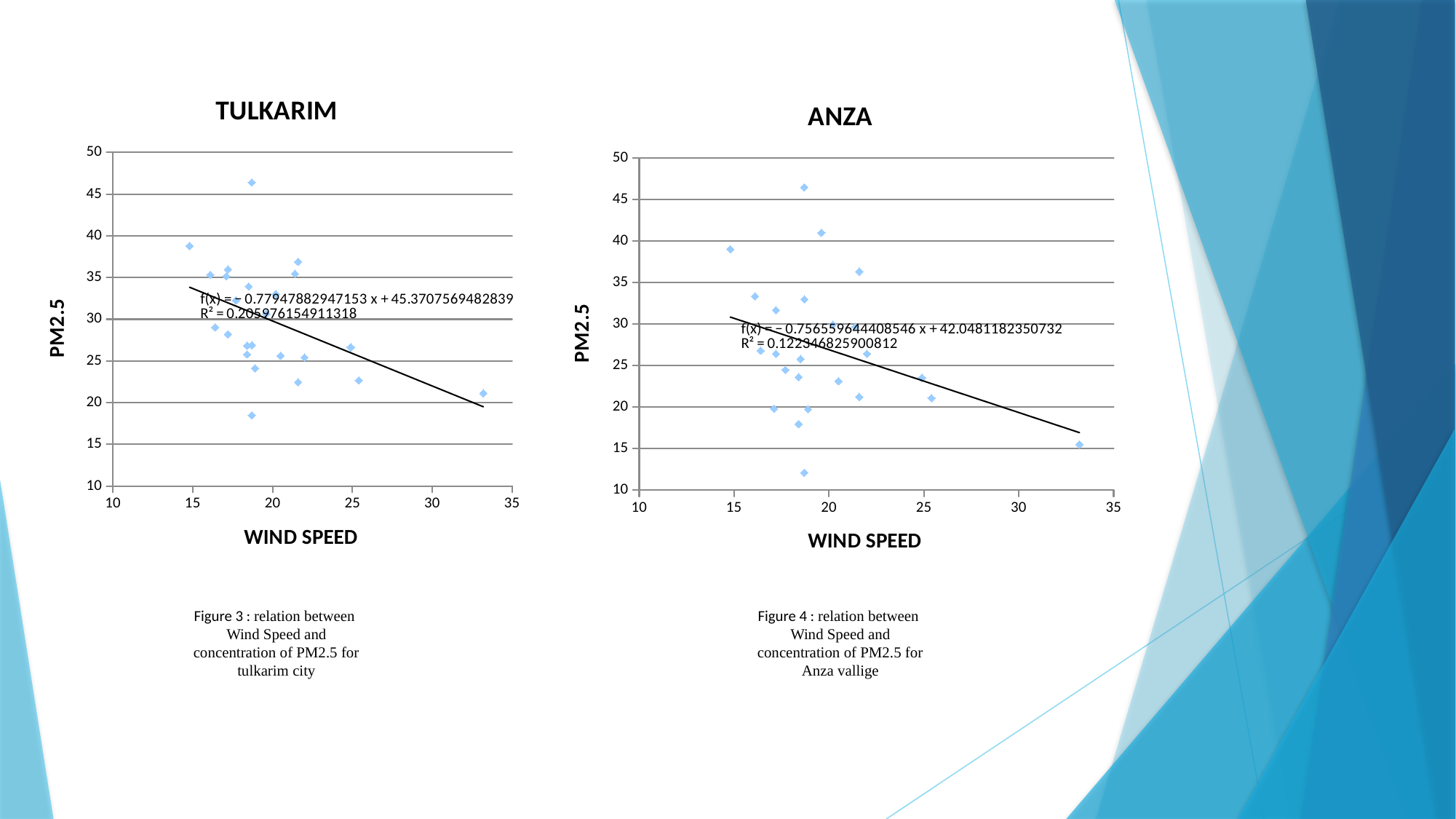
In the ANZA chart, does the fitted trend line rise or fall as wind speed increases? fall What kind of chart is the TULKARIM chart? scatter chart What is the label of the x axis on the TULKARIM chart? WIND SPEED What kind of chart is the ANZA chart? scatter chart What is the R² value printed on the ANZA chart? 0.122346825900812 What is the R² value printed on the TULKARIM chart? 0.205976154911318 In the TULKARIM chart, does the fitted trend line rise or fall as wind speed increases? fall What is the label of the y axis on the ANZA chart? PM2.5 In the TULKARIM chart, is the PM2.5 value of the point with the highest wind speed (around 33) greater or less than 20? greater In the ANZA chart, is the PM2.5 value of the lowest point greater or less than 15? less In the TULKARIM chart, is the PM2.5 value of the highest point greater or less than 45? greater